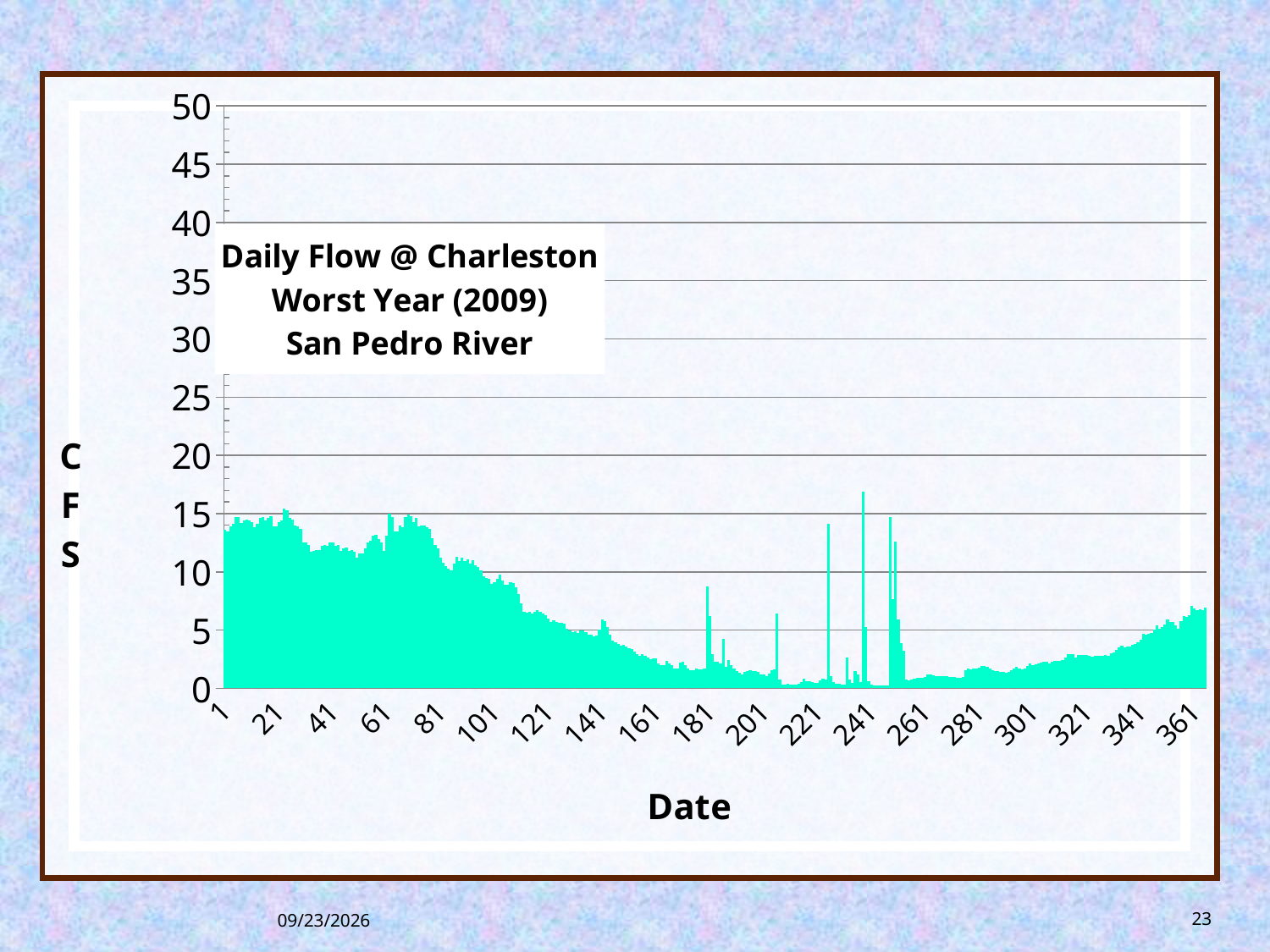
Is the value at day 281 greater or less than 5? less What kind of chart is shown on the slide? bar chart Is the value at day 1 greater or less than 20? less What is the label of the x axis? Date How many tick labels are shown on the x axis? 19 Do the values generally rise or fall from day 1 to day 161? fall What is the title of the chart? Daily Flow @ Charleston Worst Year (2009) San Pedro River Is the value at day 1 greater or less than 10? greater Do the values generally rise or fall from day 301 to day 361? rise Which is larger, the value at day 21 or the value at day 201? day 21